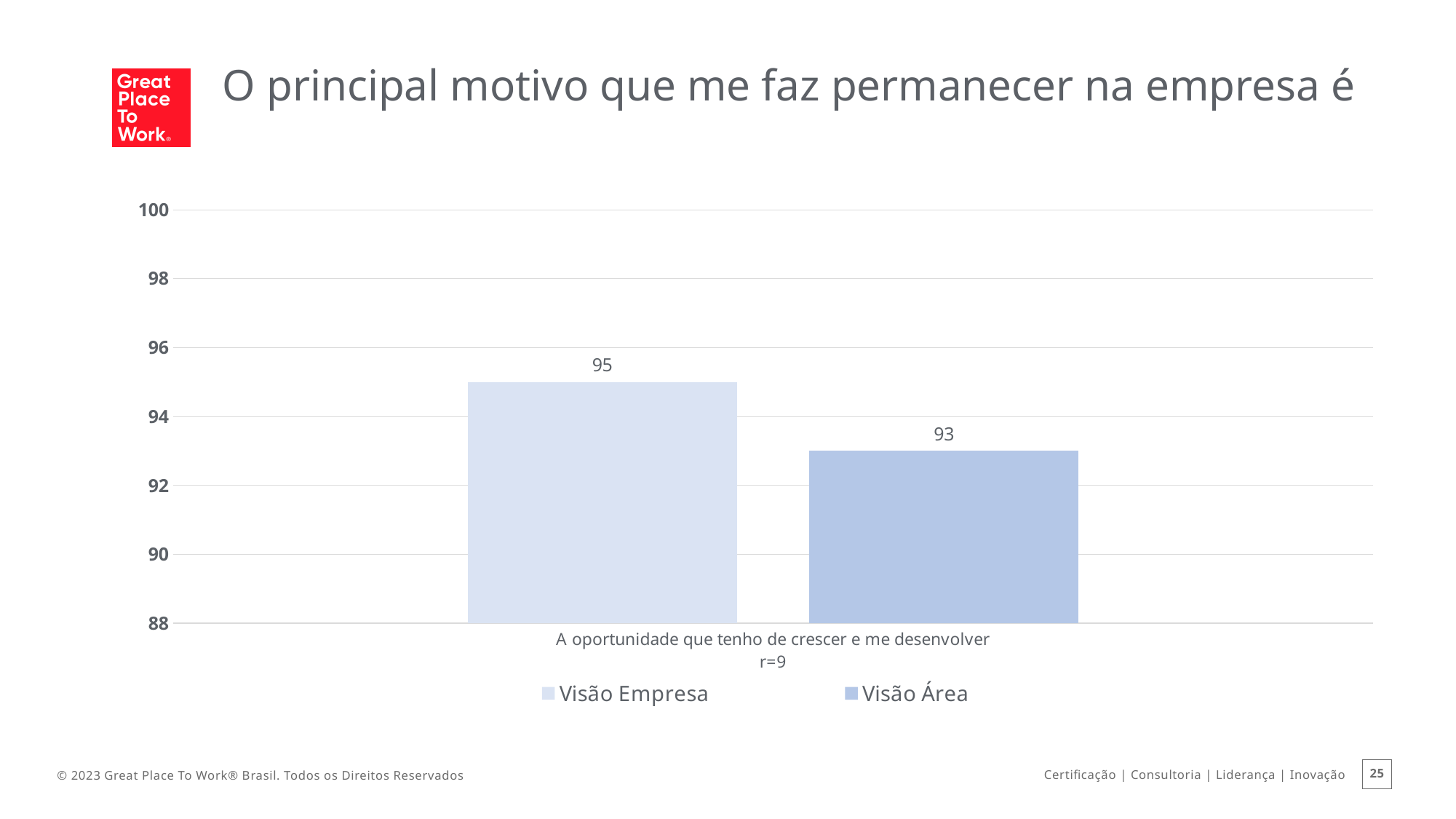
What is the category label on the x axis? A oportunidade que tenho de crescer e me desenvolver What is the value for Visão Área? 93 What is the difference between the Visão Empresa and Visão Área values? 2 Is the value for Visão Empresa greater or less than 94? greater Is the value for Visão Área greater or less than 94? less How many categories are shown on the x axis? 1 What is the value for Visão Empresa? 95 Which series has the higher value, Visão Empresa or Visão Área? Visão Empresa How many series does the legend list? 2 What is the title of the slide? O principal motivo que me faz permanecer na empresa é Which series has the lowest value? Visão Área What kind of chart is shown on the slide? bar chart